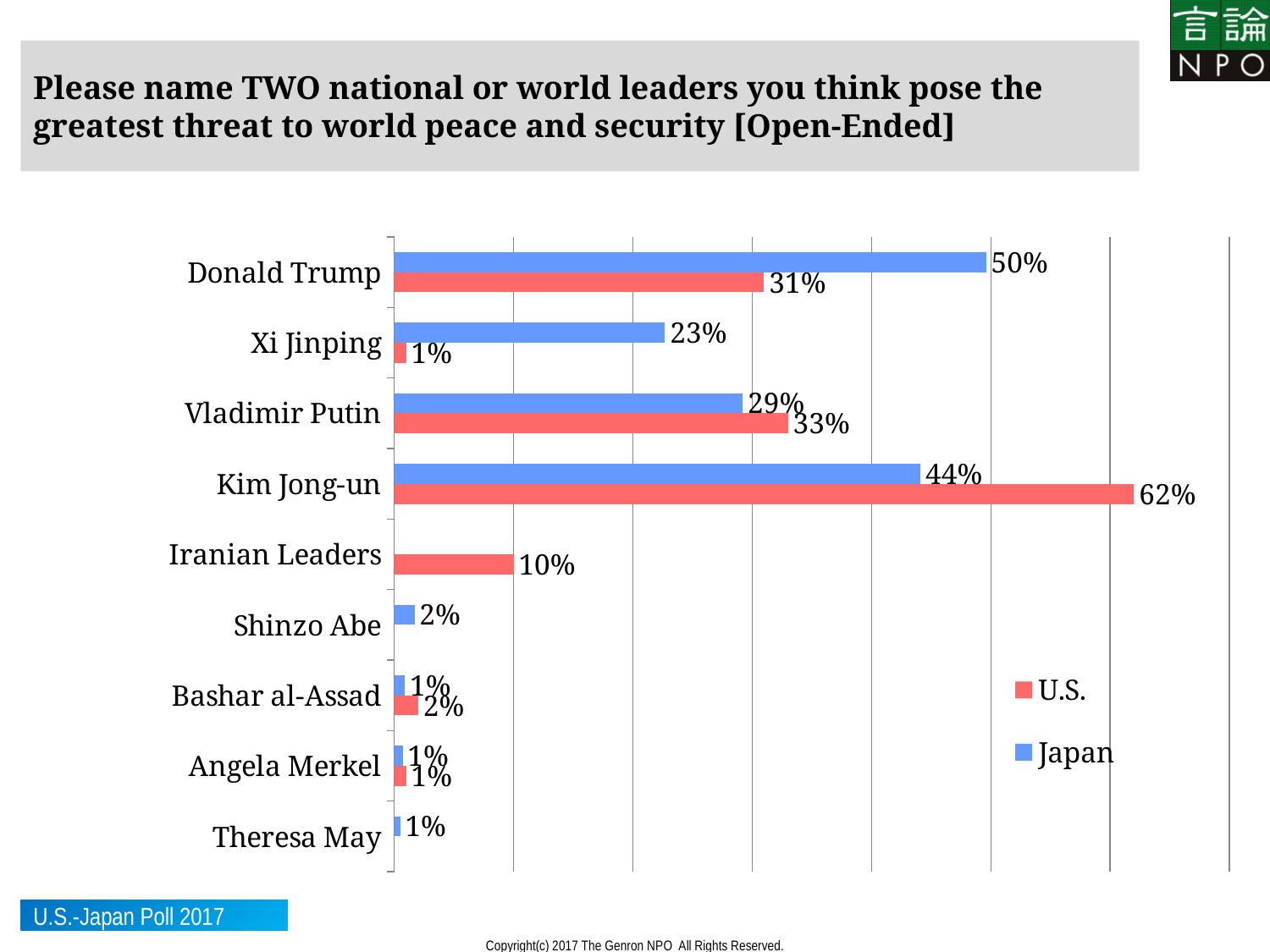
What is the difference between the U.S. and Japan percentages for Kim Jong-un? 18% For Vladimir Putin, which is larger: the U.S. percentage or the Japan percentage? U.S. How many series does the legend list? 2 How many leaders or groups are listed as categories in the chart? 9 What type of chart is shown on the slide? Bar chart What percentage of Japanese respondents named Donald Trump? 50% What is the difference between the Japan and U.S. percentages for Donald Trump? 19% What percentage of U.S. respondents named Kim Jong-un? 62% What percentage of U.S. respondents named Iranian Leaders? 10% Which leader received the highest percentage among Japanese respondents? Donald Trump Which leader received the highest percentage among U.S. respondents? Kim Jong-un What percentage of Japanese respondents named Xi Jinping? 23%